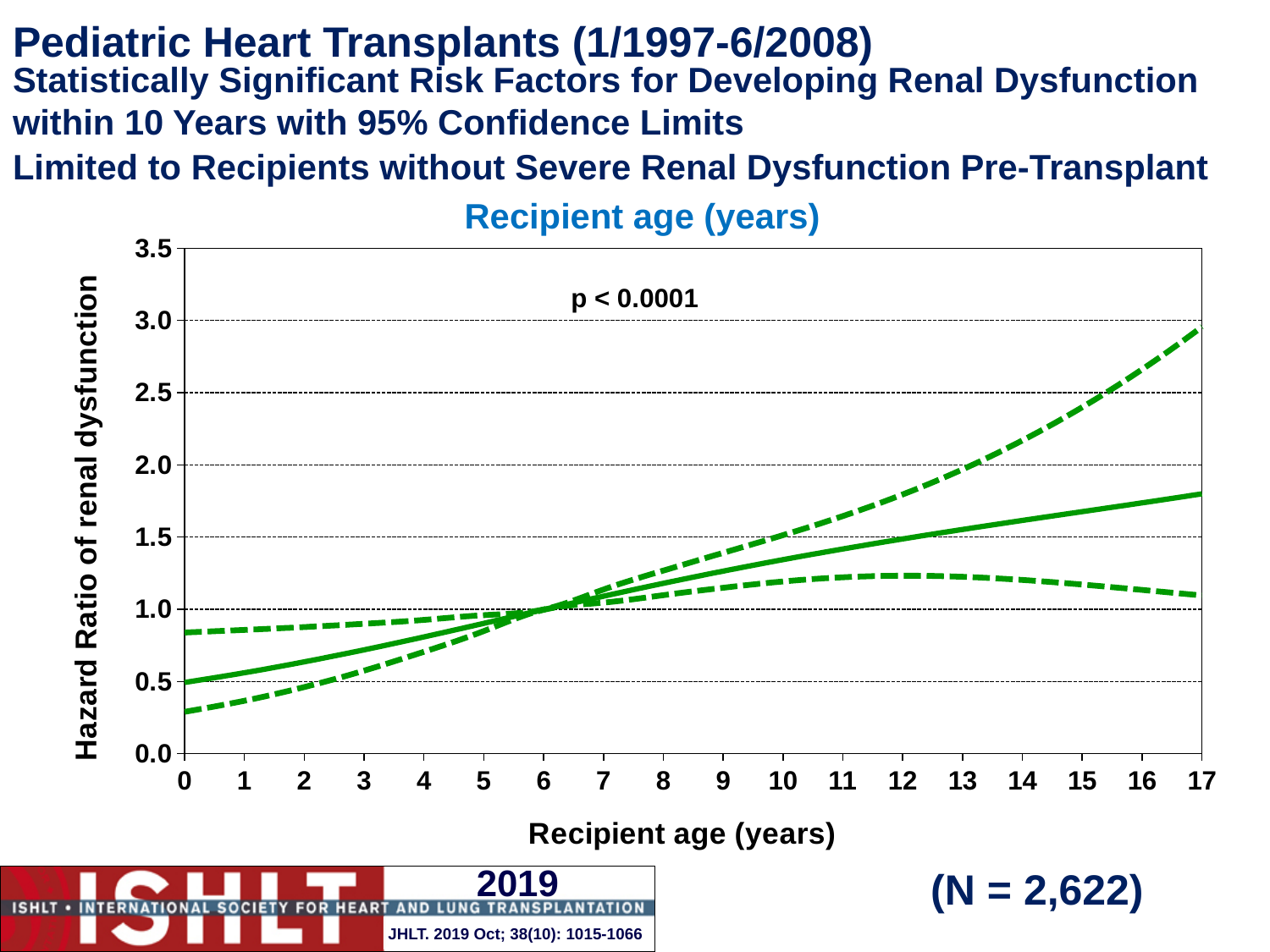
How many lines are plotted on the chart? 3 What is the label of the y axis? Hazard Ratio of renal dysfunction What kind of chart is shown on the slide? line chart Is the upper dashed confidence limit at recipient age 17 greater or less than 2.5? greater Is the solid hazard ratio line at recipient age 0 greater or less than 1.0? less Does the solid hazard ratio line rise or fall as recipient age increases? rises Is the lower dashed confidence limit at recipient age 0 greater or less than 0.5? less What p-value is printed on the chart? p < 0.0001 At recipient age 17, which is higher: the upper dashed confidence limit or the solid hazard ratio line? the upper dashed confidence limit